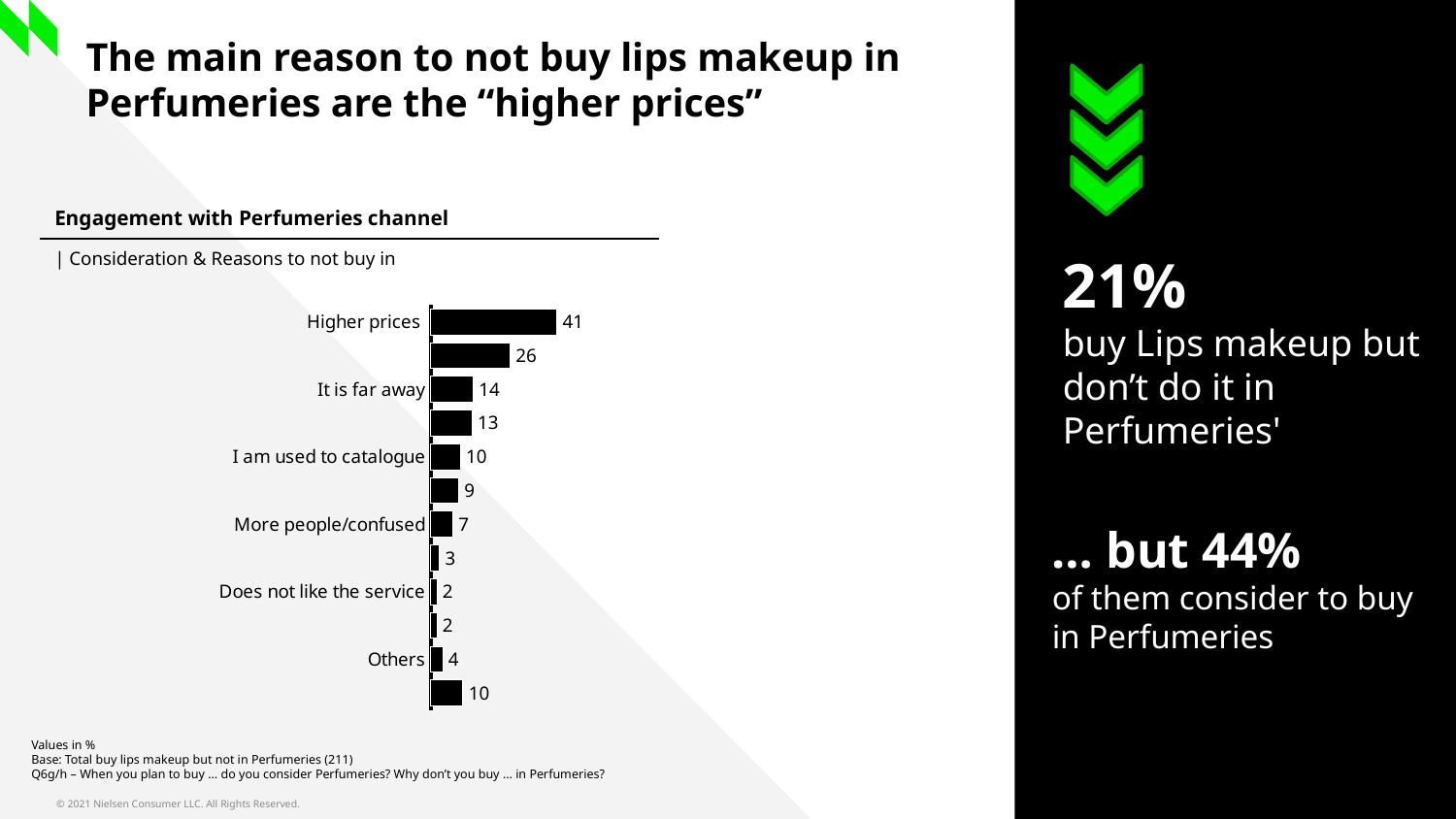
What is the value for "I am used to catalogue"? 10 What is the value for "Others"? 4 What is the value for "Higher prices"? 41 What is the value for "It is far away"? 14 What is the value for "Does not like the service"? 2 What kind of chart is shown on the slide? Bar chart What is the difference between the values for "Higher prices" and "It is far away"? 27 Which labelled reason has the lowest value? Does not like the service How many bars are plotted in the chart? 12 Which labelled reason has the highest value? Higher prices Which is larger, the value for "I am used to catalogue" or the value for "More people/confused"? I am used to catalogue What is the value for "More people/confused"? 7